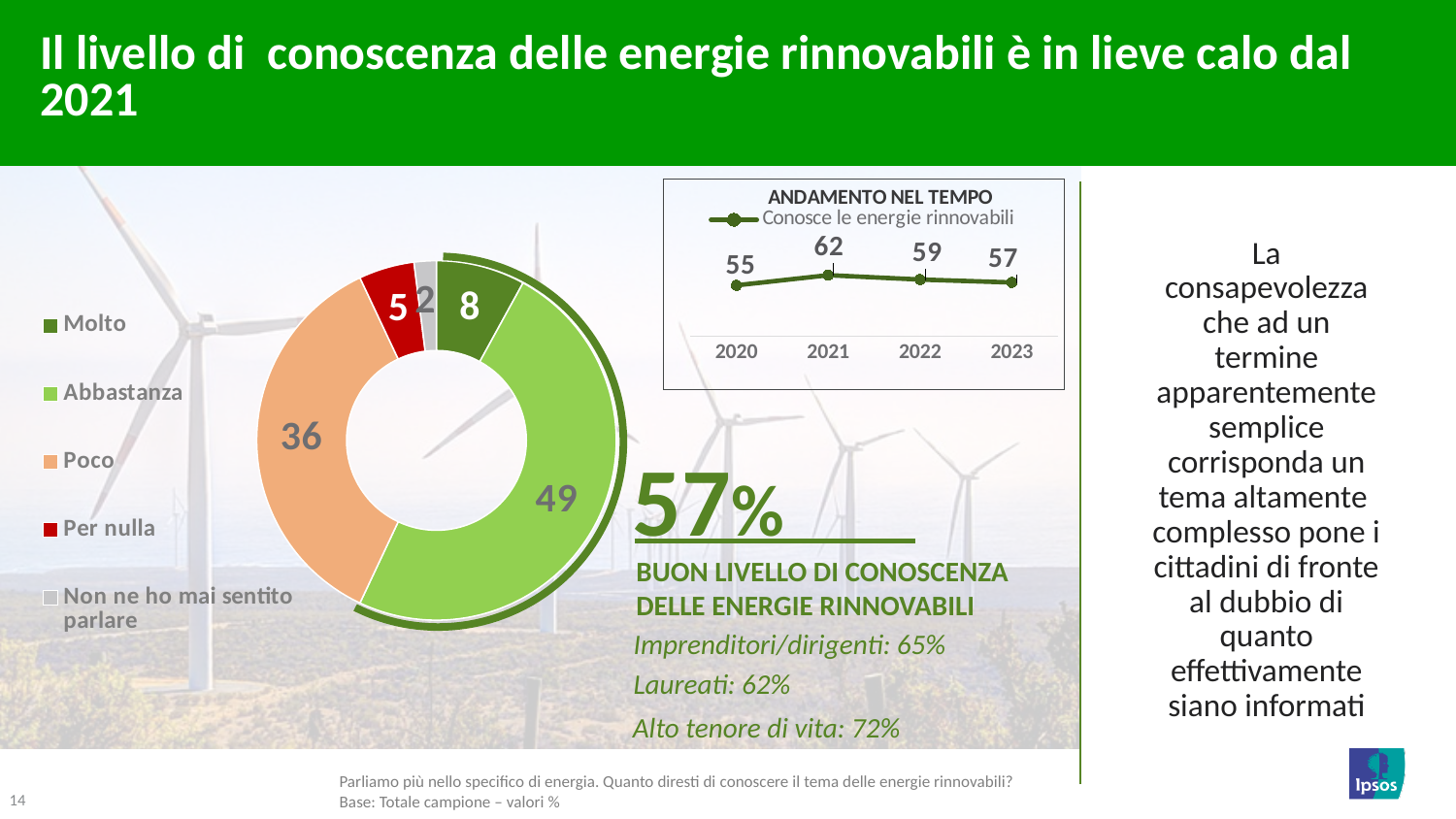
In the "ANDAMENTO NEL TEMPO" chart, what is the value for 2023? 57 In the doughnut chart, which category has the smallest value? Non ne ho mai sentito parlare In the "ANDAMENTO NEL TEMPO" chart, what is the value for 2021? 62 In the "ANDAMENTO NEL TEMPO" chart, do the values rise or fall from 2021 to 2023? fall In the doughnut chart, how many categories does the legend list? 5 In the doughnut chart, what is the value for "Molto"? 8 What kind of chart is the "ANDAMENTO NEL TEMPO" chart? line chart In the "ANDAMENTO NEL TEMPO" chart, which year has the highest value? 2021 In the doughnut chart, what is the value for "Abbastanza"? 49 In the doughnut chart, what is the difference between the values for "Abbastanza" and "Poco"? 13 In the doughnut chart, which category has the largest value? Abbastanza In the doughnut chart, what is the value for "Poco"? 36